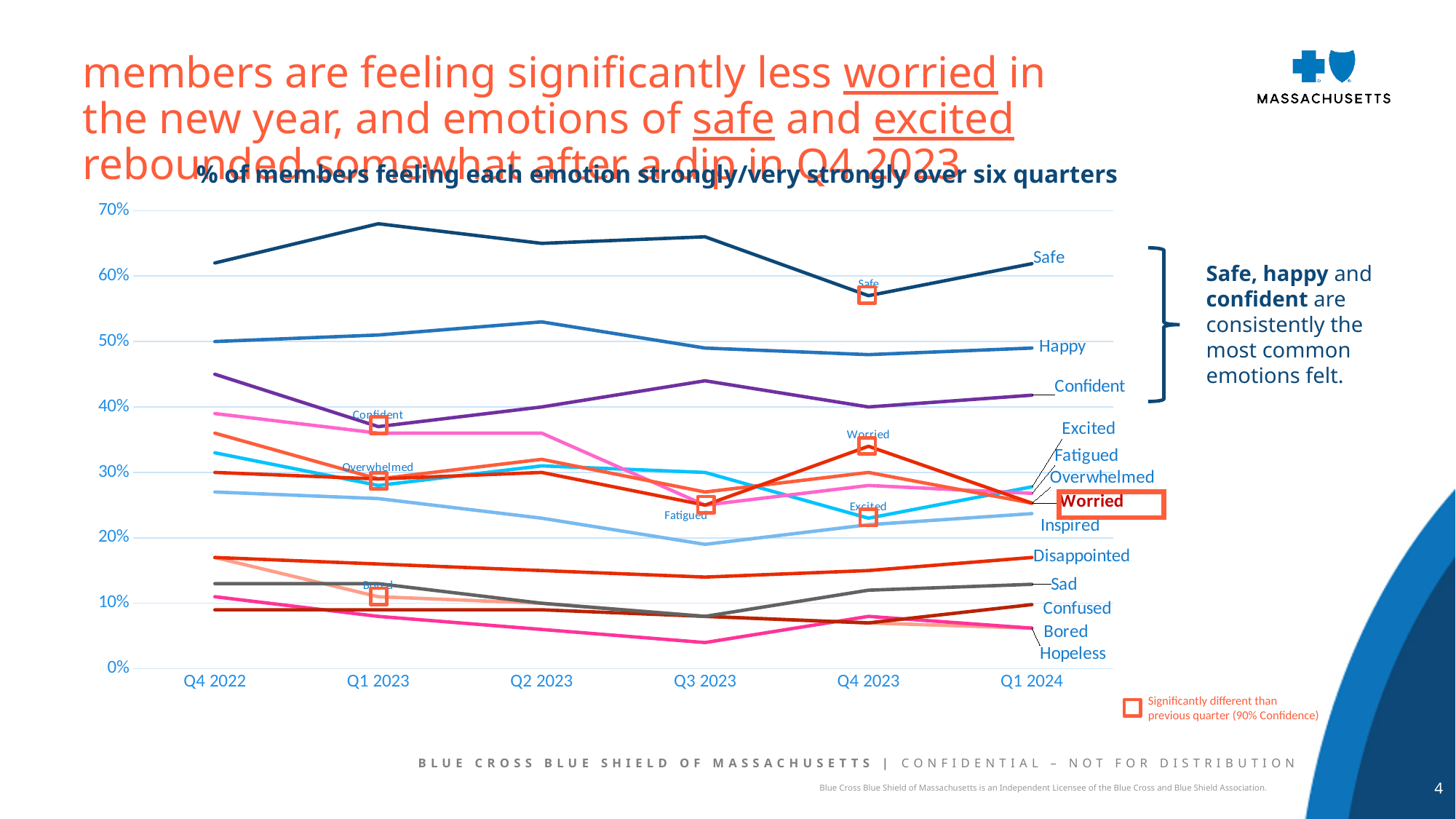
Is the value for Worried in Q4 2023 greater or less than 30%? greater Is the value for Confident in Q4 2022 greater or less than 40%? greater Which is larger in Q1 2023, the value for Safe or the value for Happy? Safe Is the value for Safe in Q4 2023 greater or less than 60%? less What is the title of the chart? % of members feeling each emotion strongly/very strongly over six quarters Which emotion has the highest value in Q1 2024? Safe Does the Worried line rise or fall from Q4 2023 to Q1 2024? fall What kind of chart is shown on the slide? line chart How many quarters are plotted along the x axis of the chart? 6 Which emotion has the lowest value in Q3 2023? Hopeless How many emotion series are labelled on the chart? 13